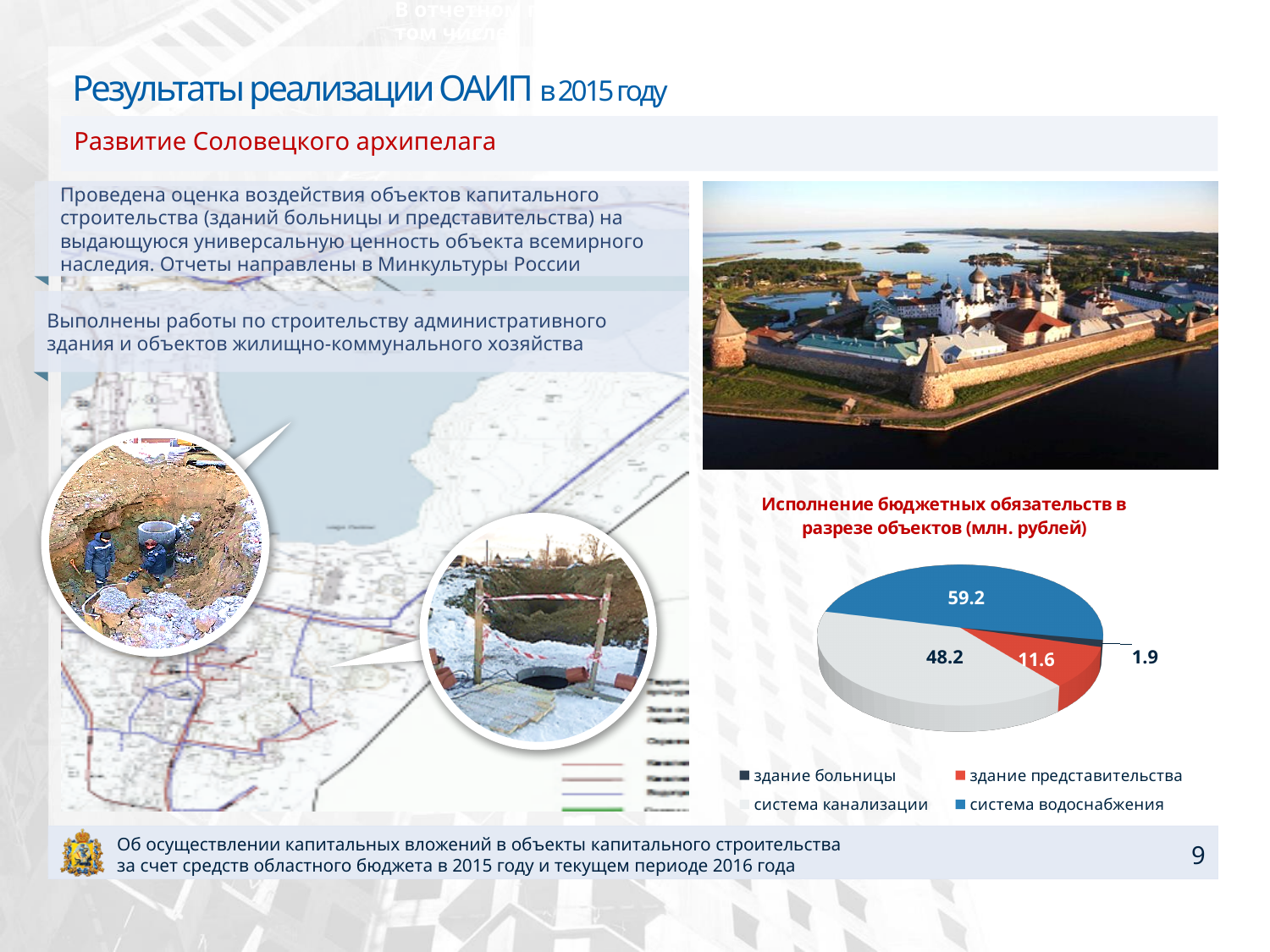
Which category has the smallest value in the pie chart? здание больницы What is the value for система канализации in the pie chart? 48.2 How many slices does the pie chart have? 4 What kind of chart is shown on the slide? pie chart How many series does the legend of the pie chart list? 4 What is the difference between the values for система водоснабжения and система канализации? 11.0 What is the value for система водоснабжения in the pie chart? 59.2 What is the value for здание больницы in the pie chart? 1.9 What is the value for здание представительства in the pie chart? 11.6 Which category has the largest value in the pie chart? система водоснабжения What is the title of the pie chart? Исполнение бюджетных обязательств в разрезе объектов (млн. рублей) Which is larger in the pie chart: здание представительства or здание больницы? здание представительства